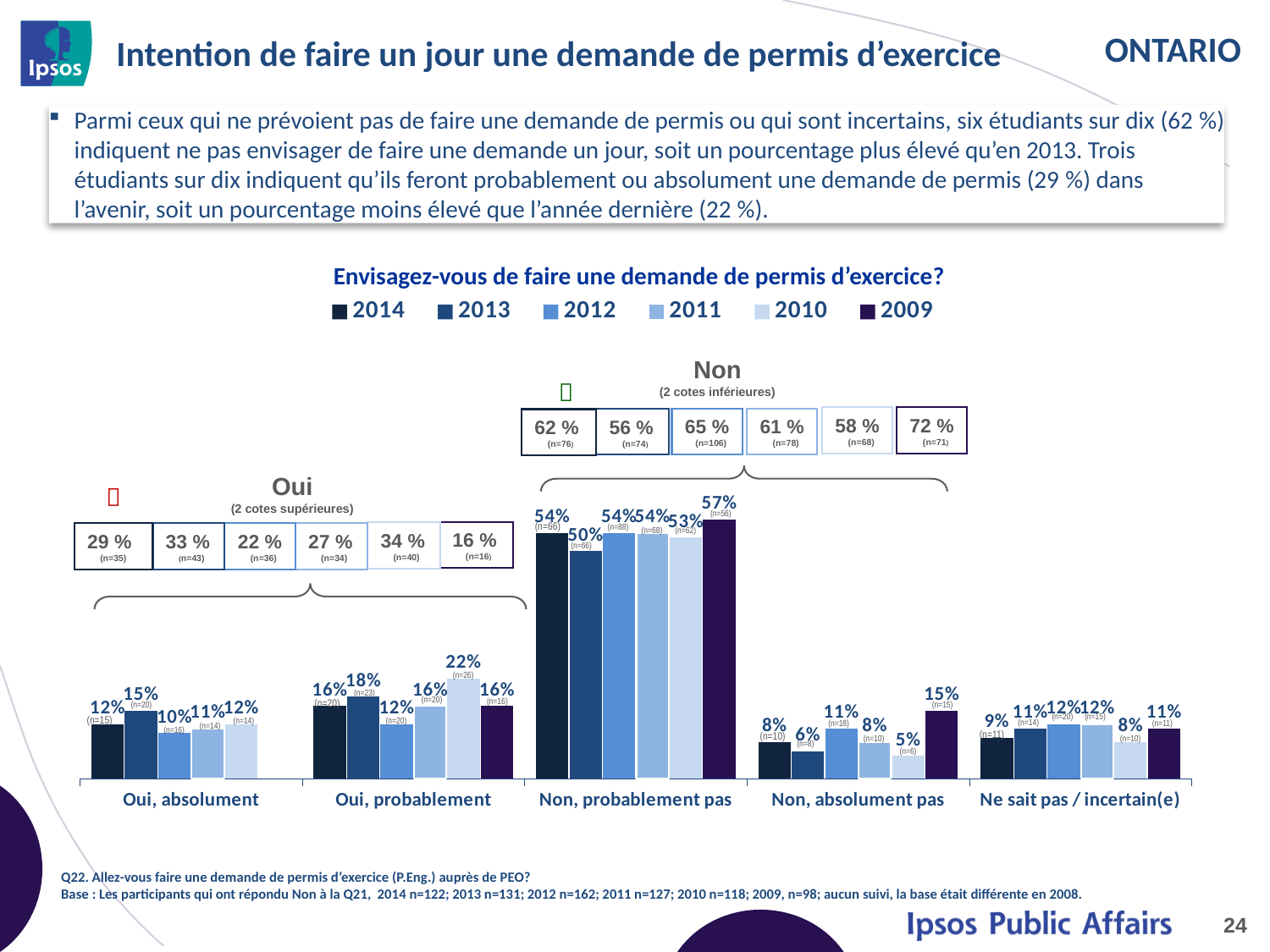
Which is larger for "Oui, absolument": the 2013 value or the 2012 value? 2013 Which year has the highest value for "Non, probablement pas"? 2009 In the "Non (2 cotes inférieures)" summary boxes, what is the 2009 value? 72 % How many response categories are shown along the x axis of the chart? 5 What is the difference between the 2009 and 2013 values for "Non, probablement pas"? 7% What is the 2009 value for "Non, absolument pas"? 15% What is the 2010 value for "Oui, probablement"? 22% How many series does the chart legend list? 6 What is the 2014 value for "Non, probablement pas"? 54% What kind of chart is shown on the slide? bar chart Which year has the lowest value for "Non, absolument pas"? 2010 What is the title of the chart? Envisagez-vous de faire une demande de permis d'exercice?